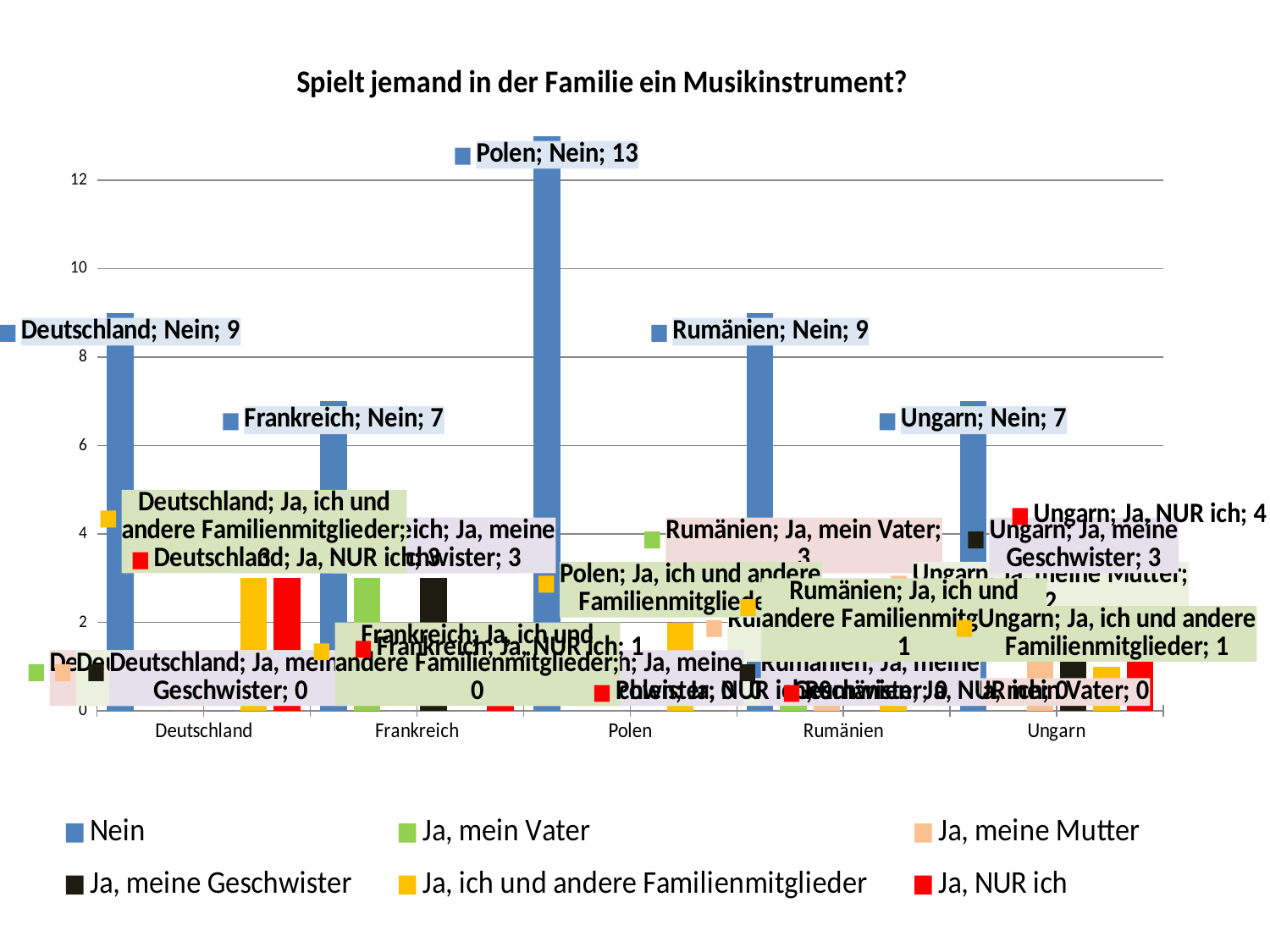
Which country has the highest value for 'Nein'? Polen Which is larger: the 'Nein' value for Rumänien or for Ungarn? Rumänien What is the value for 'Nein' for Ungarn? 7 How many series does the legend list? 6 What is the title of the chart? Spielt jemand in der Familie ein Musikinstrument? What is the difference between the 'Nein' values for Polen and Frankreich? 6 What is the value for 'Nein' for Deutschland? 9 What type of chart is shown on the slide? bar chart What is the value for 'Ja, mein Vater' for Rumänien? 3 What is the value for 'Nein' for Polen? 13 What is the value for 'Ja, NUR ich' for Ungarn? 4 How many countries are shown on the x axis? 5